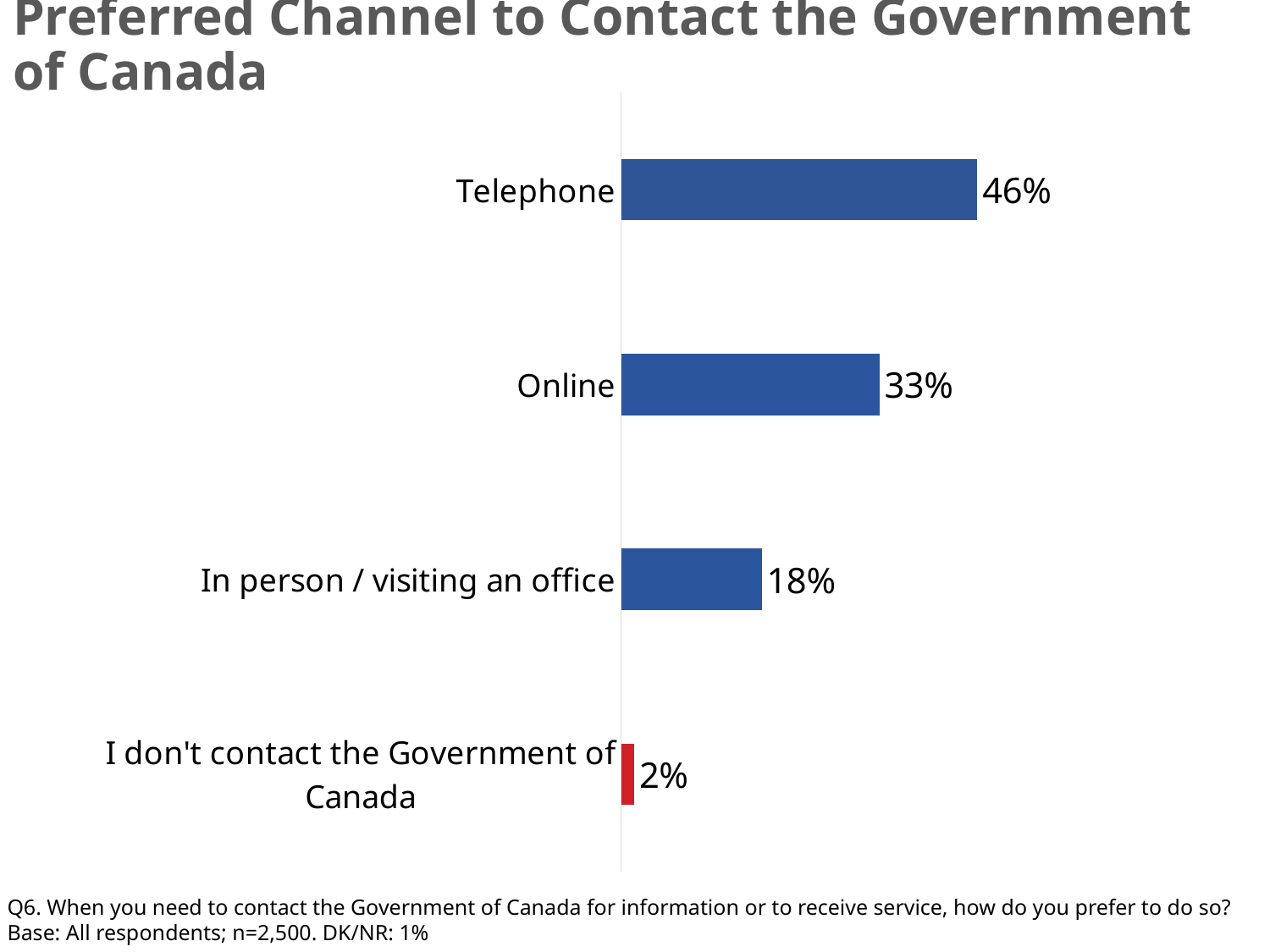
Which bar is coloured red rather than blue? I don't contact the Government of Canada What is the value shown for Online? 33% Which category has the lowest percentage? I don't contact the Government of Canada What percentage prefer In person / visiting an office? 18% What is the value for 'I don't contact the Government of Canada'? 2% How many categories are shown in the chart? 4 What is the difference between the Online and In person / visiting an office percentages? 15% Which channel has the highest percentage? Telephone What is the difference between the Telephone and Online percentages? 13% What percentage of respondents prefer Telephone as their channel to contact the Government of Canada? 46% Which is larger, the value for Online or the value for In person / visiting an office? Online What type of chart is shown on the slide? Bar chart